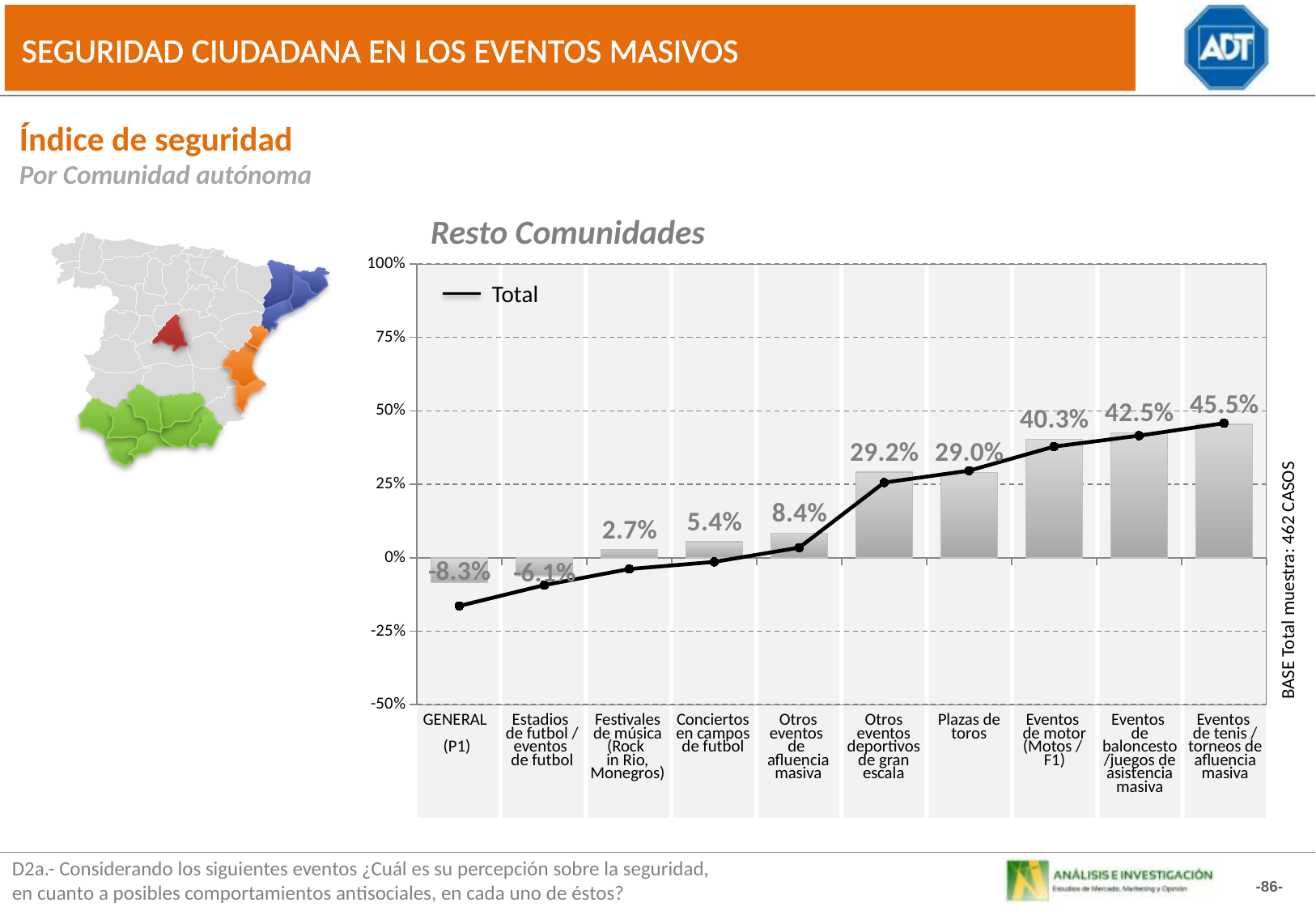
What is the value shown for GENERAL (P1) in the Resto Comunidades chart? -8.3% What is the title of the chart on the slide? Resto Comunidades Which category has the highest value in the Resto Comunidades chart? Eventos de tenis / torneos de afluencia masiva Do the bar values in the Resto Comunidades chart rise or fall from left to right along the x axis? rise Which category has the lowest value in the Resto Comunidades chart? GENERAL (P1) In the Resto Comunidades chart, is the Total line value for GENERAL (P1) greater or less than 0%? less What is the difference between the values for Eventos de tenis / torneos de afluencia masiva and Eventos de motor (Motos / F1) in the Resto Comunidades chart? 5.2 percentage points What is the value shown for Plazas de toros in the Resto Comunidades chart? 29.0% In the Resto Comunidades chart, which is larger: the value for Conciertos en campos de futbol or the value for Otros eventos de afluencia masiva? Otros eventos de afluencia masiva What is the value shown for Eventos de motor (Motos / F1) in the Resto Comunidades chart? 40.3% How many categories are shown on the x axis of the Resto Comunidades chart? 10 How many series does the legend of the Resto Comunidades chart list? 1